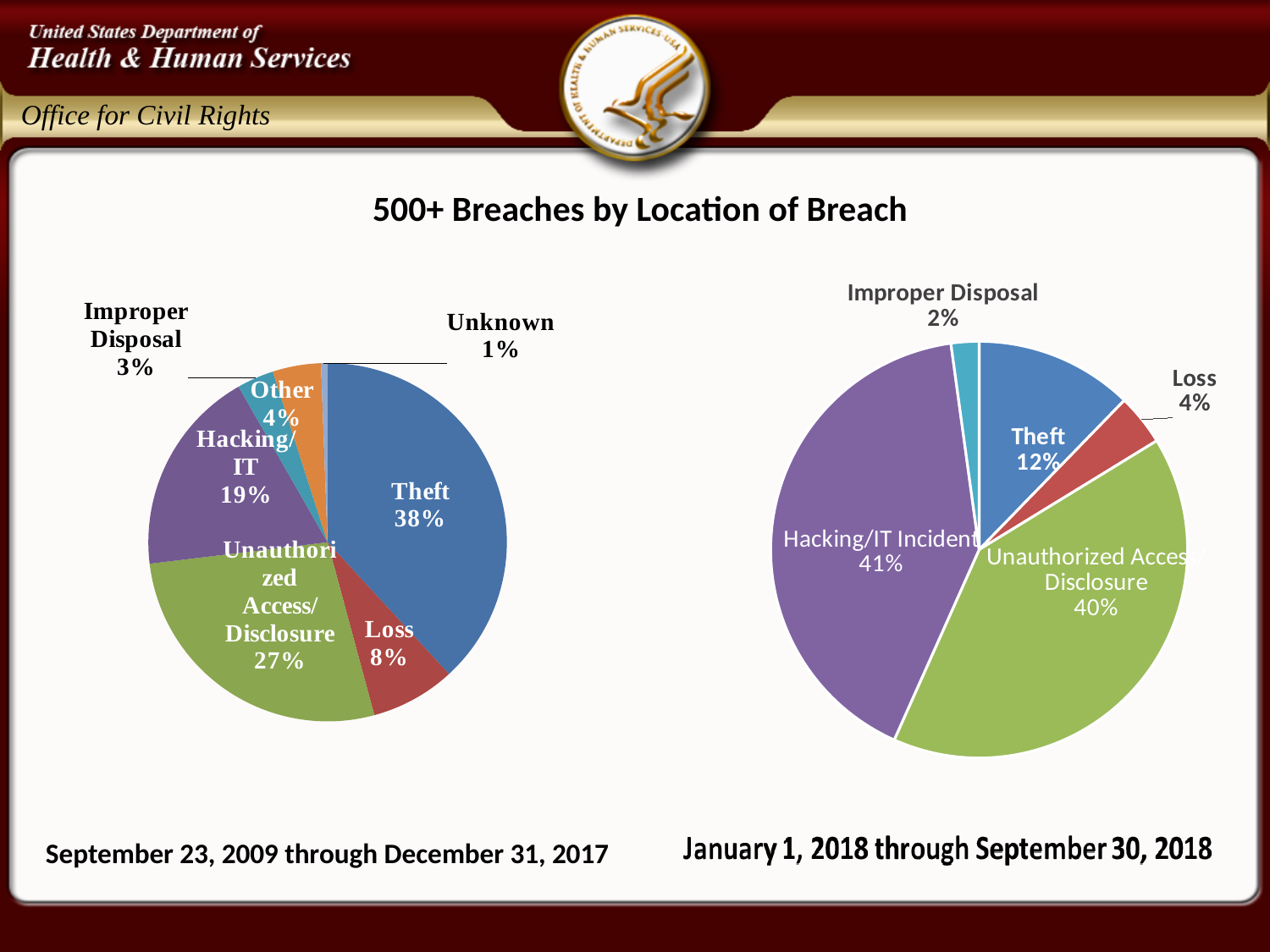
How many slices does the pie chart for September 23, 2009 through December 31, 2017 have? 7 In the pie chart for September 23, 2009 through December 31, 2017, what share of breaches is attributed to Hacking/IT? 19% In the pie chart for January 1, 2018 through September 30, 2018, what share of breaches is attributed to Loss? 4% In the pie chart for January 1, 2018 through September 30, 2018, which category has the smallest share? Improper Disposal In the pie chart for January 1, 2018 through September 30, 2018, what share of breaches is attributed to Hacking/IT Incident? 41% How many slices does the pie chart for January 1, 2018 through September 30, 2018 have? 5 In the pie chart for September 23, 2009 through December 31, 2017, what share of breaches is attributed to Theft? 38% In the pie chart for September 23, 2009 through December 31, 2017, which category has the largest share? Theft In the pie chart for January 1, 2018 through September 30, 2018, which is larger: Theft or Unauthorized Access/Disclosure? Unauthorized Access/Disclosure In the pie chart for September 23, 2009 through December 31, 2017, which category has the smallest share? Unknown In the pie chart for September 23, 2009 through December 31, 2017, what is the difference in percentage points between Theft and Unauthorized Access/Disclosure? 11 percentage points What type of chart is used on this slide to show breaches by location of breach? Pie chart